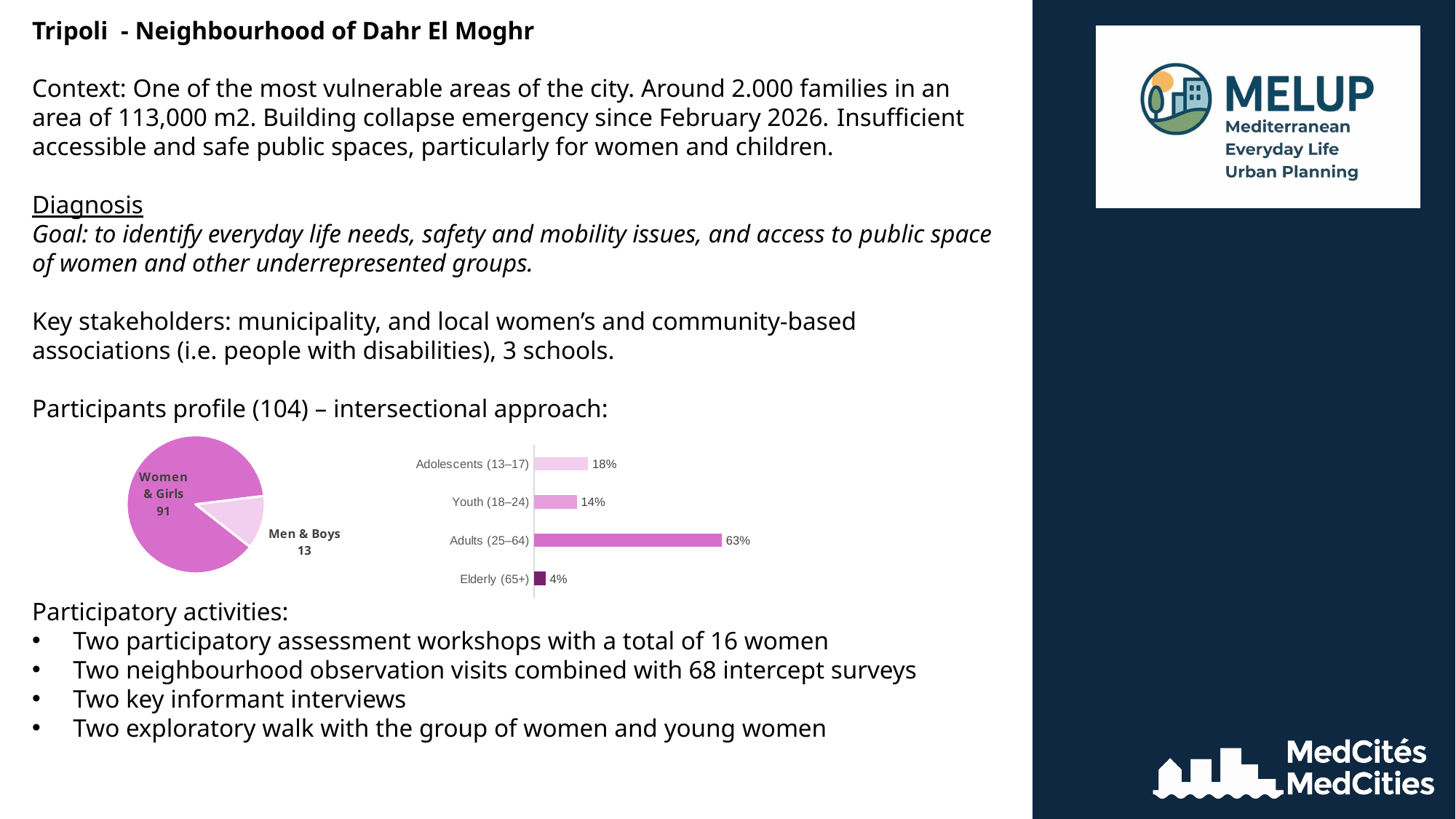
In the bar chart on the right, what is the value for Elderly (65+)? 4% In the pie chart on the left, what is the difference between the Women & Girls value and the Men & Boys value? 78 In the bar chart on the right, which age group has the highest value? Adults (25–64) In the bar chart on the right, what is the value for Adults (25–64)? 63% In the pie chart on the left, how many slices are there? 2 In the pie chart on the left, what is the value for Women & Girls? 91 In the bar chart on the right, which age group has the lowest value? Elderly (65+) In the pie chart on the left, which slice is larger, Women & Girls or Men & Boys? Women & Girls What kind of chart is the chart on the left showing Women & Girls and Men & Boys? pie chart In the pie chart on the left, what is the value for Men & Boys? 13 In the bar chart on the right, how many age groups are shown? 4 In the bar chart on the right, what is the difference between Adolescents (13–17) and Youth (18–24)? 4%